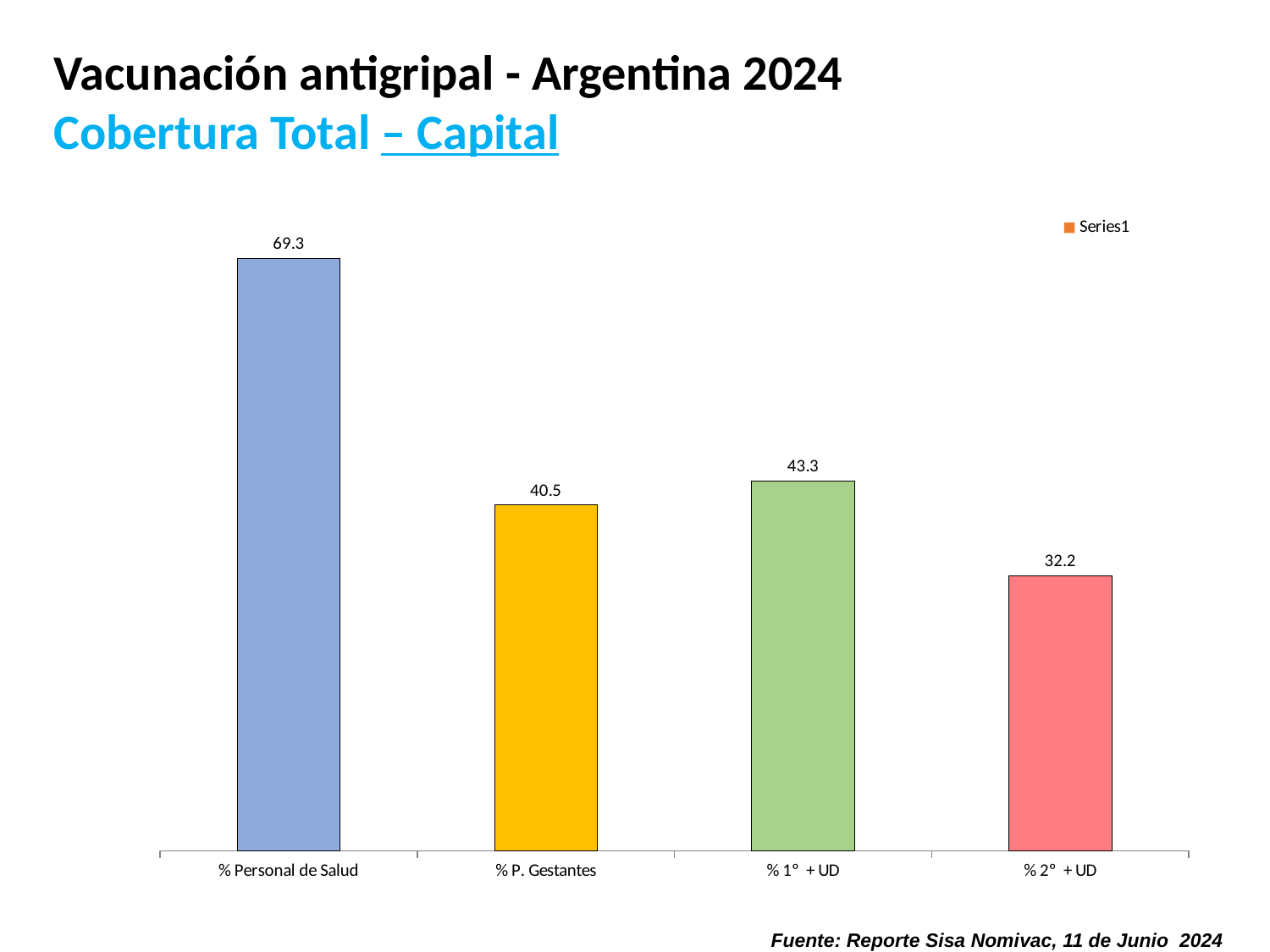
What is the difference between the values for % 1° + UD and % P. Gestantes? 2.8 How many categories are shown on the chart? 4 What is the difference between the values for % Personal de Salud and % 2° + UD? 37.1 What kind of chart is shown on the slide? bar chart Which category has the lowest value? % 2° + UD Which category has the highest value? % Personal de Salud What is the value for % P. Gestantes? 40.5 What is the value for % Personal de Salud? 69.3 What is the value for % 2° + UD? 32.2 What series name does the legend show? Series1 What is the value for % 1° + UD? 43.3 Which is larger, the value for % 1° + UD or the value for % P. Gestantes? % 1° + UD